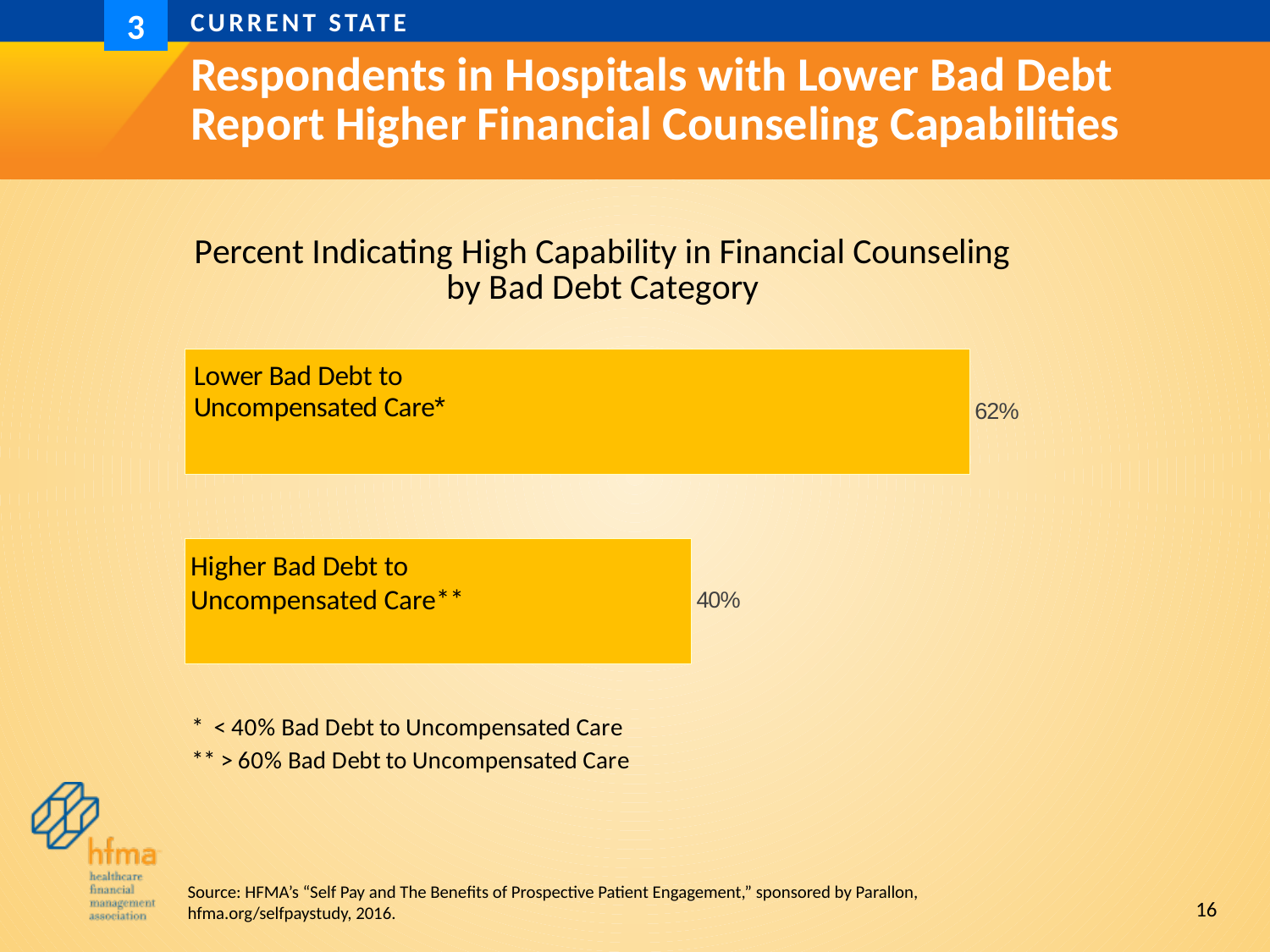
Which bad debt category has the higher percent indicating high capability in financial counseling? Lower Bad Debt to Uncompensated Care Is the value for Lower Bad Debt to Uncompensated Care larger or smaller than the value for Higher Bad Debt to Uncompensated Care? larger What percent of respondents in the Higher Bad Debt to Uncompensated Care category indicated high capability in financial counseling? 40% What percent of respondents in the Lower Bad Debt to Uncompensated Care category indicated high capability in financial counseling? 62% According to the footnote, what threshold defines the Lower Bad Debt to Uncompensated Care category? < 40% Bad Debt to Uncompensated Care What kind of chart is shown on the slide? bar chart What is the title of the chart? Percent Indicating High Capability in Financial Counseling by Bad Debt Category Which bad debt category has the lower percent indicating high capability in financial counseling? Higher Bad Debt to Uncompensated Care How many bad debt categories are shown in the chart? 2 What is the difference in percentage points between the Lower Bad Debt and Higher Bad Debt categories? 22 percentage points